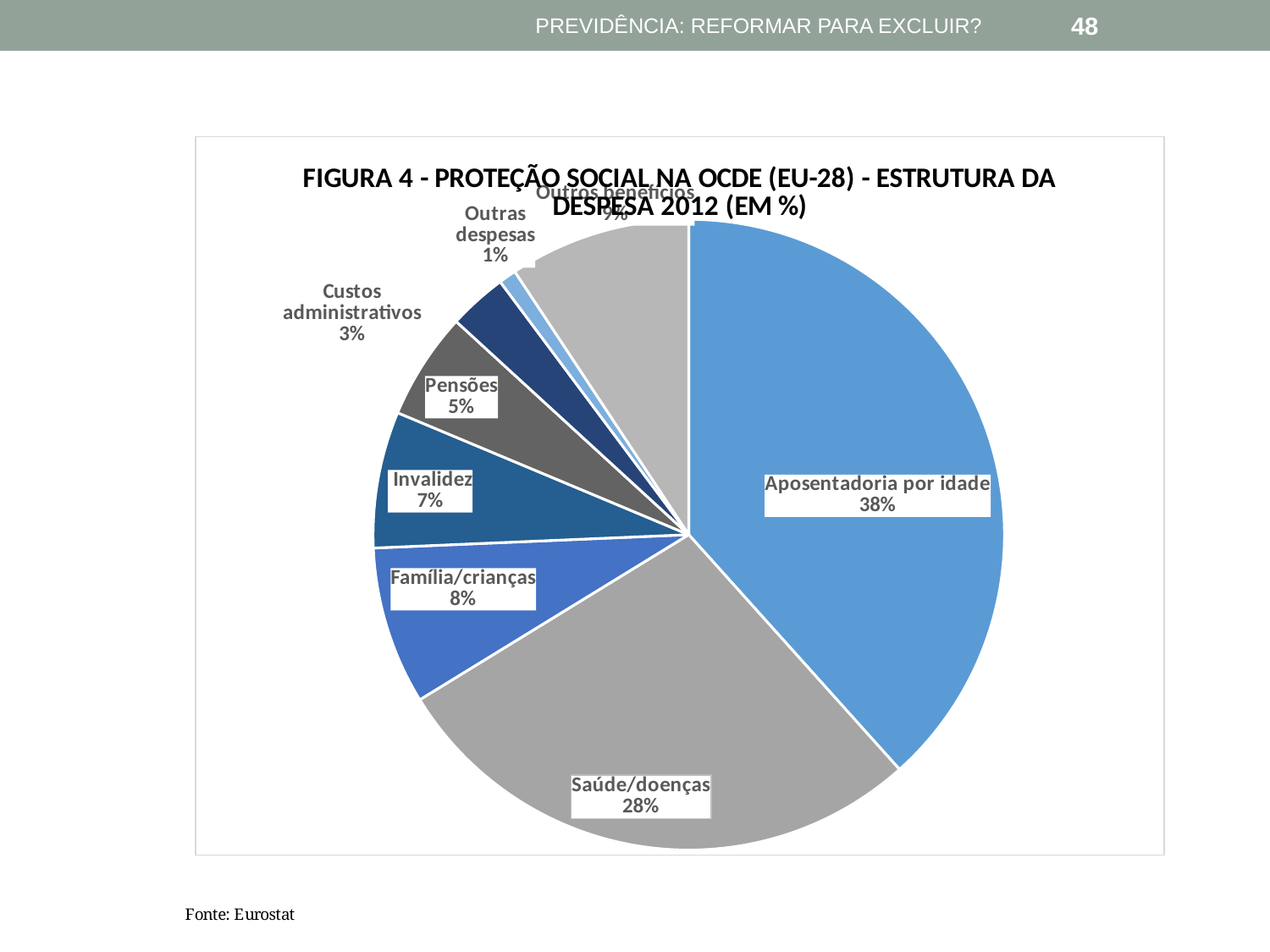
What source is cited below the chart? Eurostat What percentage is shown for Família/crianças? 8% What share of expenditure does Aposentadoria por idade account for? 38% What kind of chart is shown on the slide? pie chart What is the value for Invalidez? 7% Which is larger, the slice for Invalidez or the slice for Pensões? Invalidez Which category has the smallest slice of the pie? Outras despesas What is the difference in percentage points between Aposentadoria por idade and Saúde/doenças? 10 What is the value shown for Saúde/doenças? 28% What percentage is shown for Custos administrativos? 3% How many slices does the pie chart have? 8 Which category has the largest slice of the pie? Aposentadoria por idade